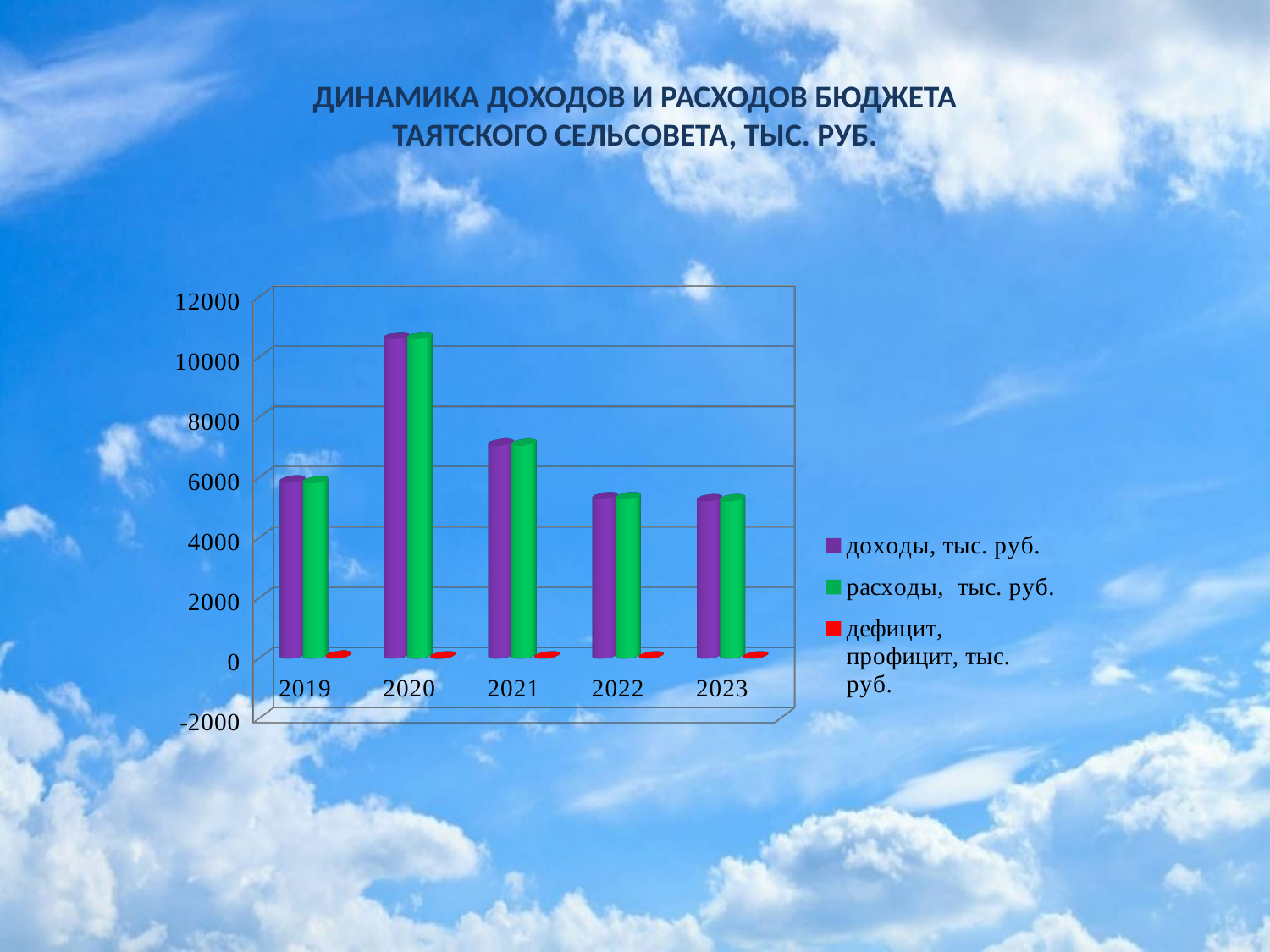
Is the value for расходы, тыс. руб. in 2023 greater or less than 4000? greater How many years are shown on the x axis of the chart? 5 In which year is the value for доходы, тыс. руб. the highest? 2020 In which year is the value for расходы, тыс. руб. the highest? 2020 Do the values for доходы, тыс. руб. rise or fall from 2020 to 2023? fall Is the value for расходы, тыс. руб. in 2021 greater or less than 6000? greater Is the value for доходы, тыс. руб. in 2022 greater or less than 6000? less How many series does the chart legend list? 3 What colour represents the series доходы, тыс. руб. in the chart? purple Which year has the larger value for доходы, тыс. руб.: 2020 or 2021? 2020 What kind of chart is shown on the slide? bar chart